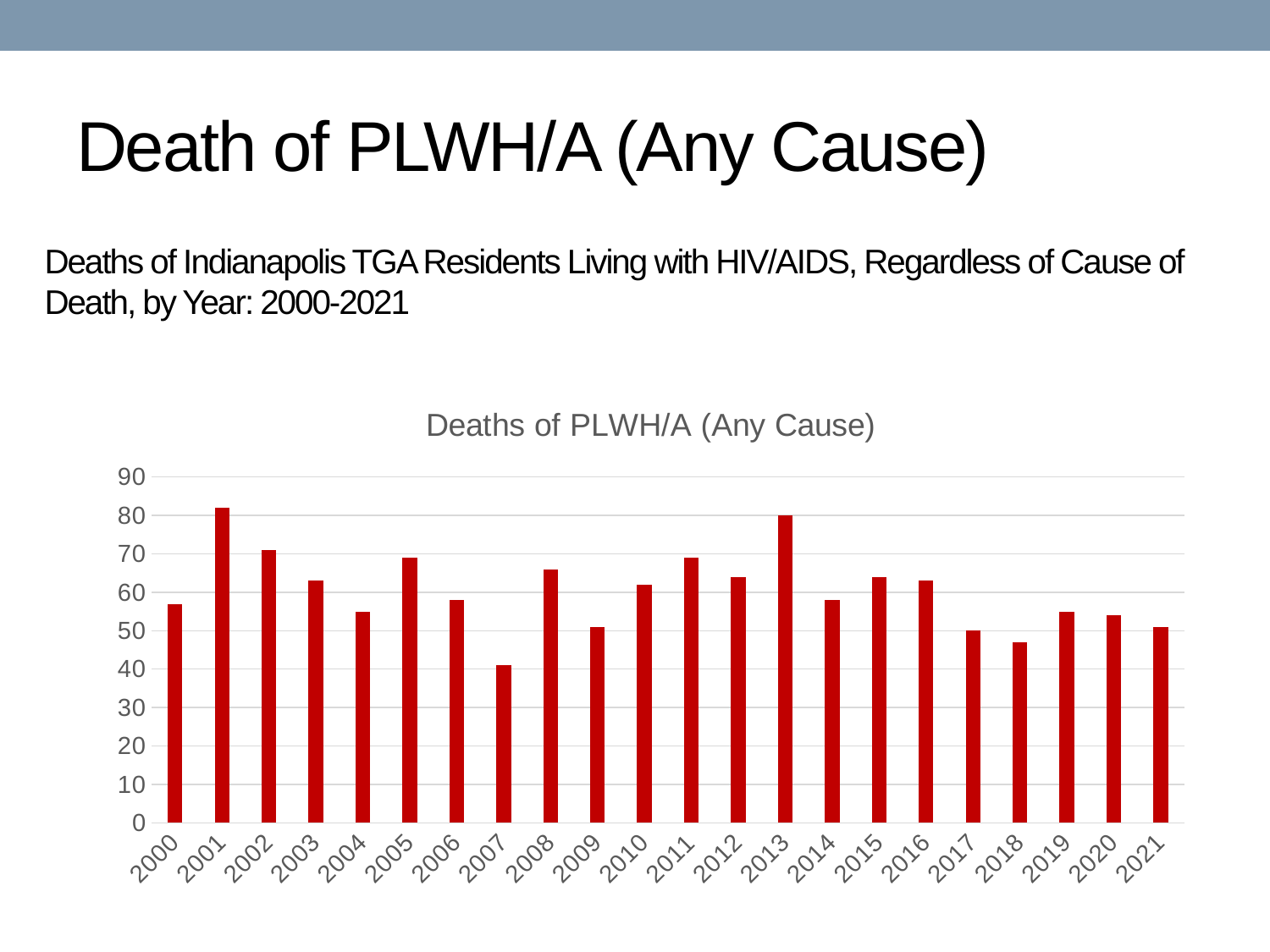
Is the value for 2005 greater or less than 60? greater How many years are plotted on the x axis of the chart? 22 Which year has the larger value, 2007 or 2008? 2008 Is the value for 2013 greater or less than 70? greater What colour are the bars in the chart? red Is the value for 2018 greater or less than 50? less What is the title of the chart? Deaths of PLWH/A (Any Cause) What kind of chart is shown on the slide? bar chart Which year has the lowest number of deaths in the chart? 2007 Which year has the larger value, 2013 or 2018? 2013